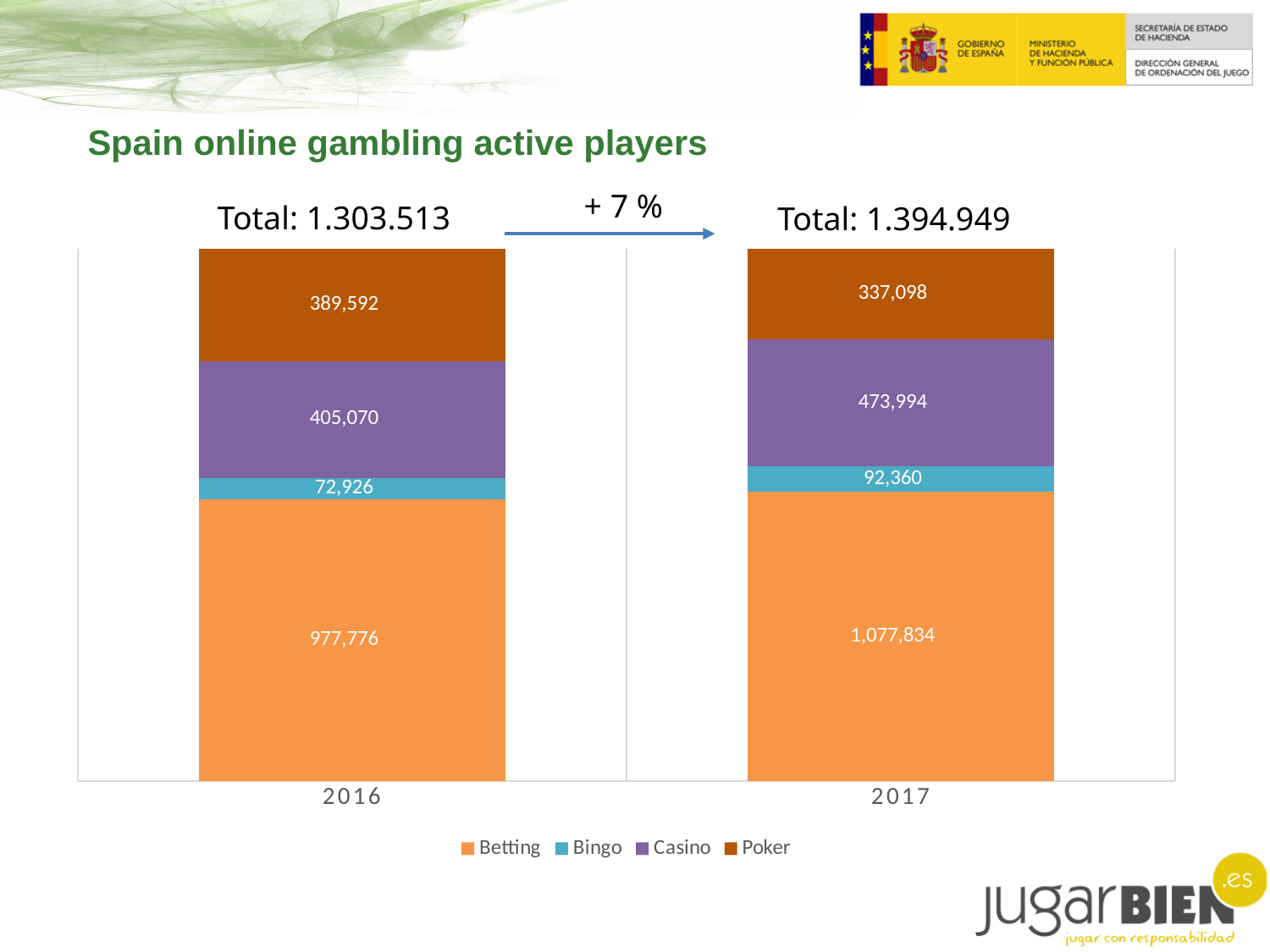
What is the value for Bingo in 2017? 92,360 How many series does the legend list? 4 Which year has the larger Poker value, 2016 or 2017? 2016 Which series has the largest segment in the 2017 bar? Betting What kind of chart is shown on the slide? stacked bar chart What is the value for Poker in 2017? 337,098 What is the value for Betting in 2016? 977,776 By how much did the Betting value increase from 2016 to 2017? 100,058 Which series has the smallest segment in the 2016 bar? Bingo Does the Casino value rise or fall from 2016 to 2017? rises How many years are shown on the x axis? 2 What percentage change is shown on the arrow between the two totals? + 7 %